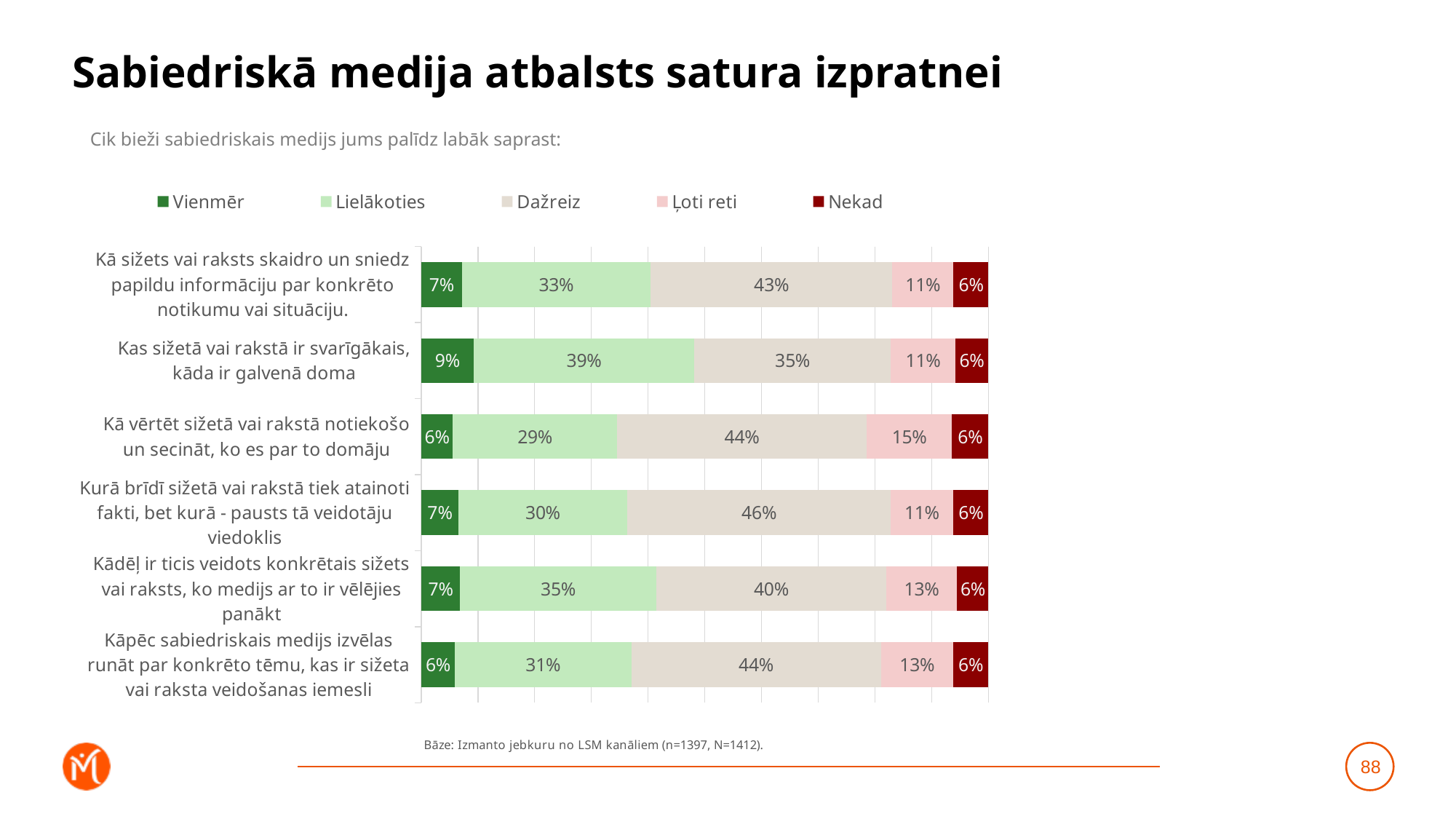
What is the difference between the 'Lielākoties' values for 'Kas sižetā vai rakstā ir svarīgākais, kāda ir galvenā doma' and 'Kā vērtēt sižetā vai rakstā notiekošo un secināt, ko es par to domāju'? 10% What is the total of the stacked bar for 'Kāpēc sabiedriskais medijs izvēlas runāt par konkrēto tēmu, kas ir sižeta vai raksta veidošanas iemesli'? 100% How many categories are shown in the chart? 6 Which category has the highest 'Dažreiz' value? Kurā brīdī sižetā vai rakstā tiek atainoti fakti, bet kurā - pausts tā veidotāju viedoklis Which category has the highest 'Vienmēr' value? Kas sižetā vai rakstā ir svarīgākais, kāda ir galvenā doma What is the 'Ļoti reti' value for 'Kā vērtēt sižetā vai rakstā notiekošo un secināt, ko es par to domāju'? 15% What is the 'Dažreiz' value for 'Kas sižetā vai rakstā ir svarīgākais, kāda ir galvenā doma'? 35% Which is larger: the 'Dažreiz' value for 'Kā sižets vai raksts skaidro un sniedz papildu informāciju par konkrēto notikumu vai situāciju' or for 'Kādēļ ir ticis veidots konkrētais sižets vai raksts, ko medijs ar to ir vēlējies panākt'? Kā sižets vai raksts skaidro un sniedz papildu informāciju par konkrēto notikumu vai situāciju What is the 'Lielākoties' value for 'Kādēļ ir ticis veidots konkrētais sižets vai raksts, ko medijs ar to ir vēlējies panākt'? 35% How many series does the legend list? 5 Which category has the lowest 'Lielākoties' value? Kā vērtēt sižetā vai rakstā notiekošo un secināt, ko es par to domāju What kind of chart is shown on the slide? Stacked bar chart